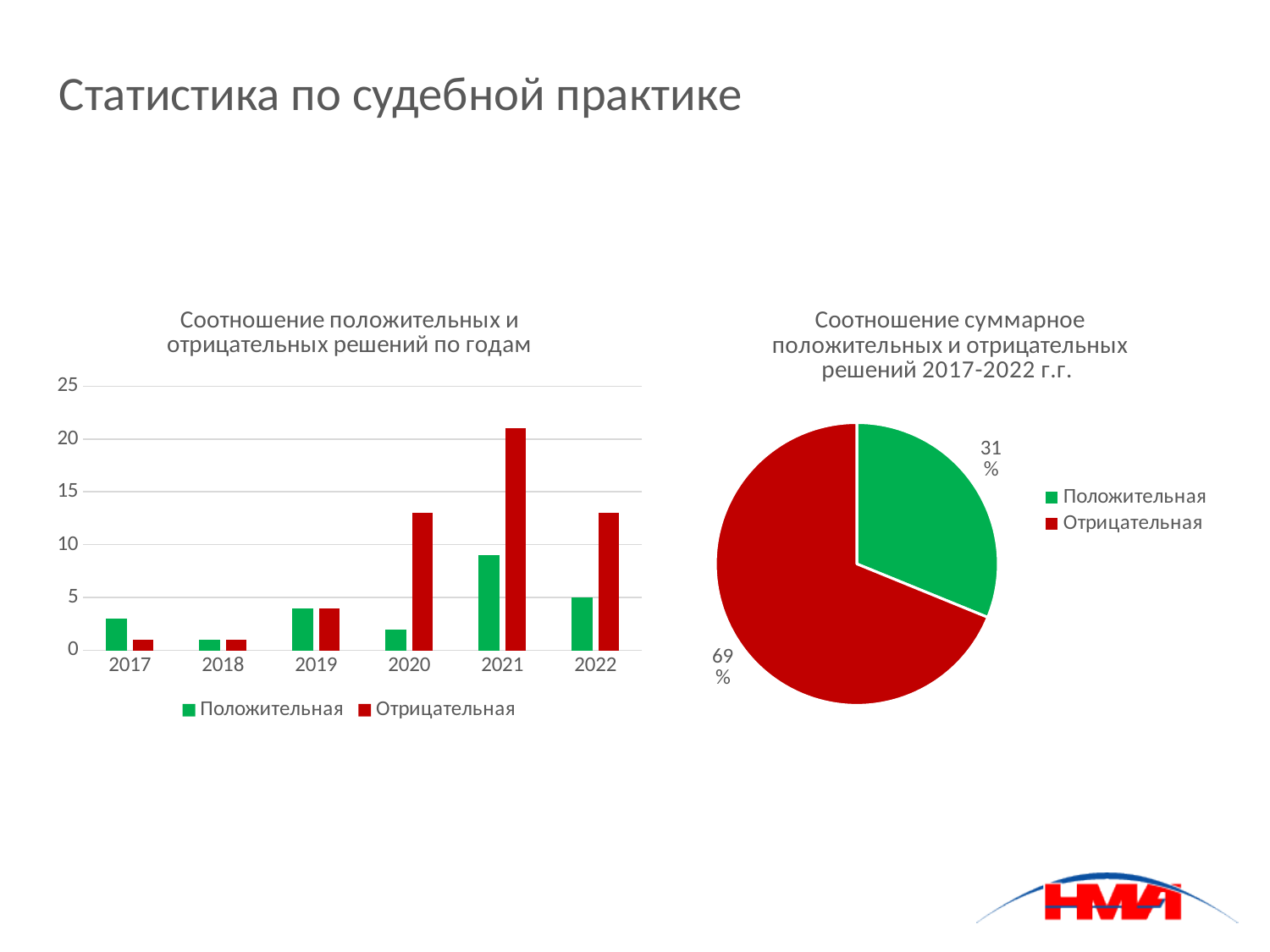
In the right pie chart, what share does Положительная have? 31% In the right pie chart, what share does Отрицательная have? 69% In the left bar chart, in which year is the Положительная value highest? 2021 In the left bar chart, is the Отрицательная value for 2021 greater or less than 15? greater In the left bar chart, for 2020, which series has the larger value, Положительная or Отрицательная? Отрицательная What kind of chart is the right chart titled "Соотношение суммарное положительных и отрицательных решений 2017-2022 г.г."? pie chart What kind of chart is the left chart titled "Соотношение положительных и отрицательных решений по годам"? bar chart In the left bar chart, how many years are shown on the x axis? 6 In the left bar chart, is the Положительная value for 2017 greater or less than 5? less In the left bar chart, in which year is the Отрицательная value highest? 2021 In the left bar chart, how many series does the legend list? 2 In the left bar chart, is the Отрицательная value for 2020 greater or less than 10? greater